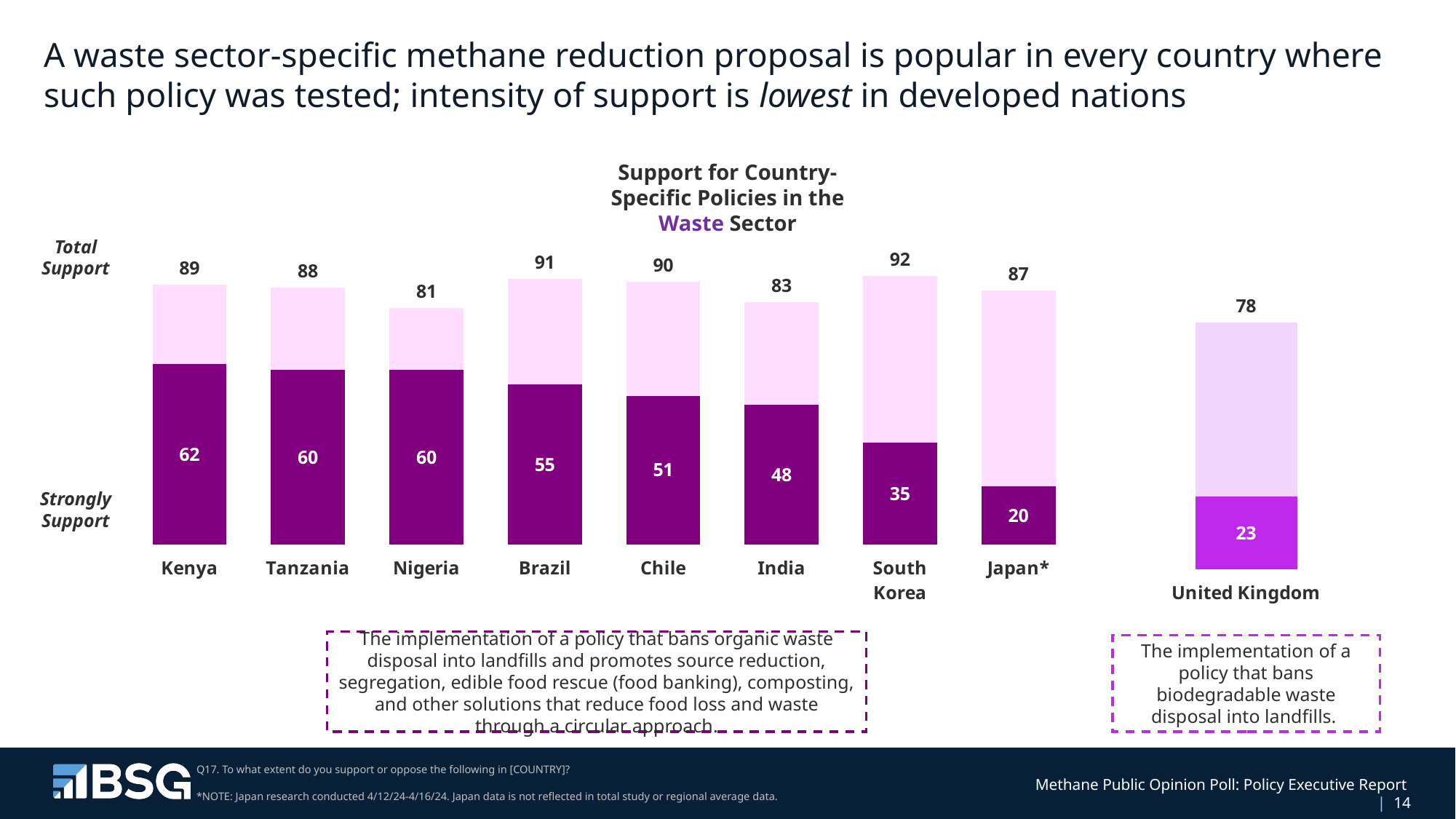
What is the difference between Total Support and Strongly Support for Kenya? 27 What is the Strongly Support value for Japan? 20 Which country has the lowest Total Support? United Kingdom Which country has the lowest Strongly Support value? Japan Which country has the highest Total Support? South Korea Which has a higher Total Support, Brazil or Chile? Brazil What is the Total Support value for Kenya? 89 How many countries are shown in the chart? 9 Which country has the highest Strongly Support value? Kenya What is the Strongly Support value for the United Kingdom? 23 What kind of chart is shown on the slide? Stacked bar chart What is the total of the stacked bar for India? 83